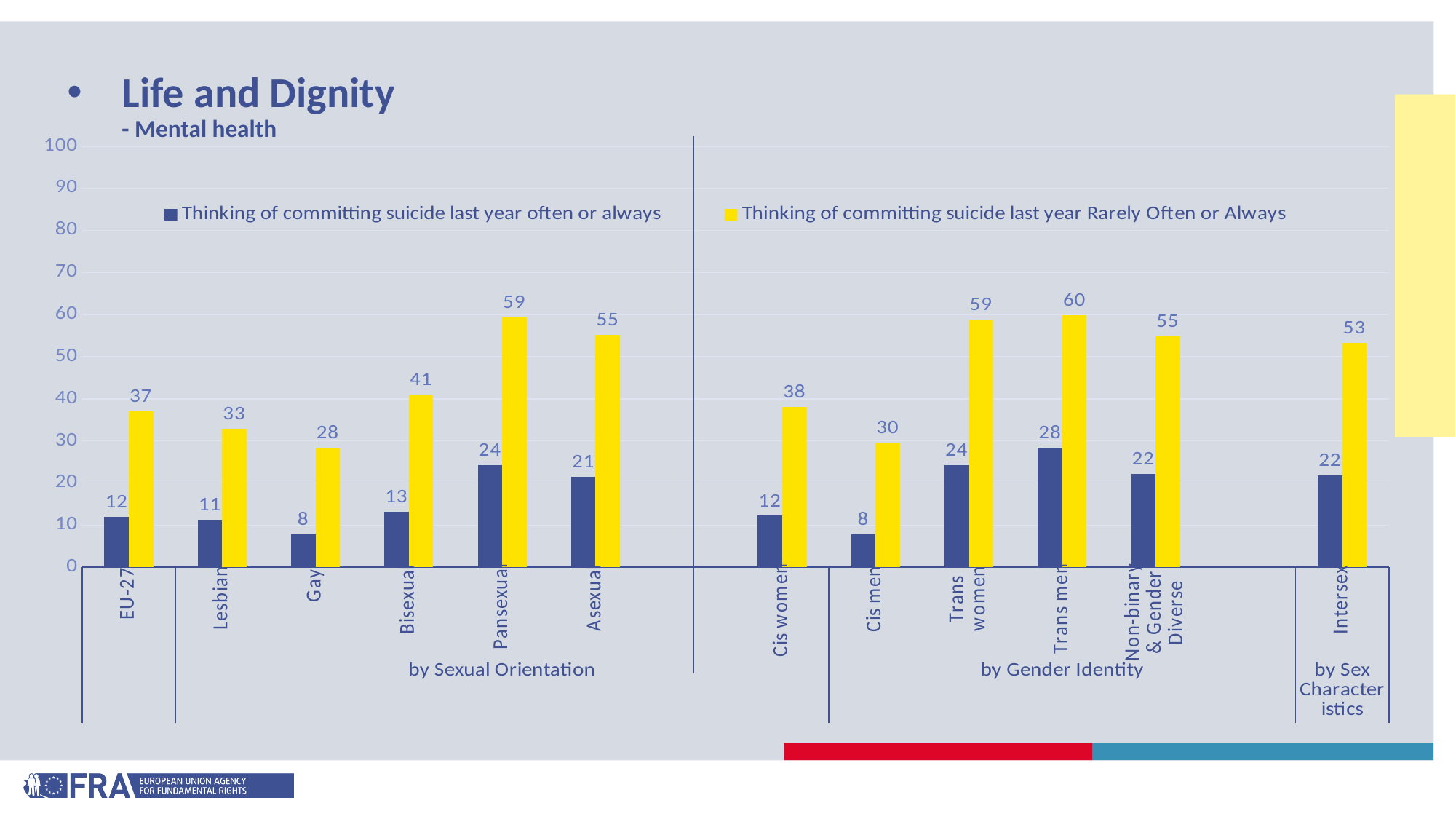
How many series does the legend list? 2 Which category has the lowest value in the 'Thinking of committing suicide last year Rarely Often or Always' series? Gay Which category has the highest value in the 'Thinking of committing suicide last year often or always' series? Trans men What is the value for Pansexual in the 'Thinking of committing suicide last year Rarely Often or Always' series? 59 What is the value for Trans men in the 'Thinking of committing suicide last year often or always' series? 28 What is the value for Intersex in the 'Thinking of committing suicide last year Rarely Often or Always' series? 53 How many categories are shown on the x axis of the chart? 12 Which is larger: the 'Thinking of committing suicide last year often or always' value for Asexual or for Cis women? Asexual Which category has the highest value in the 'Thinking of committing suicide last year Rarely Often or Always' series? Trans men What kind of chart is shown on the slide? Bar chart What colour represents the 'Thinking of committing suicide last year Rarely Often or Always' series? Yellow What is the difference between the 'Rarely Often or Always' value and the 'often or always' value for Bisexual? 28